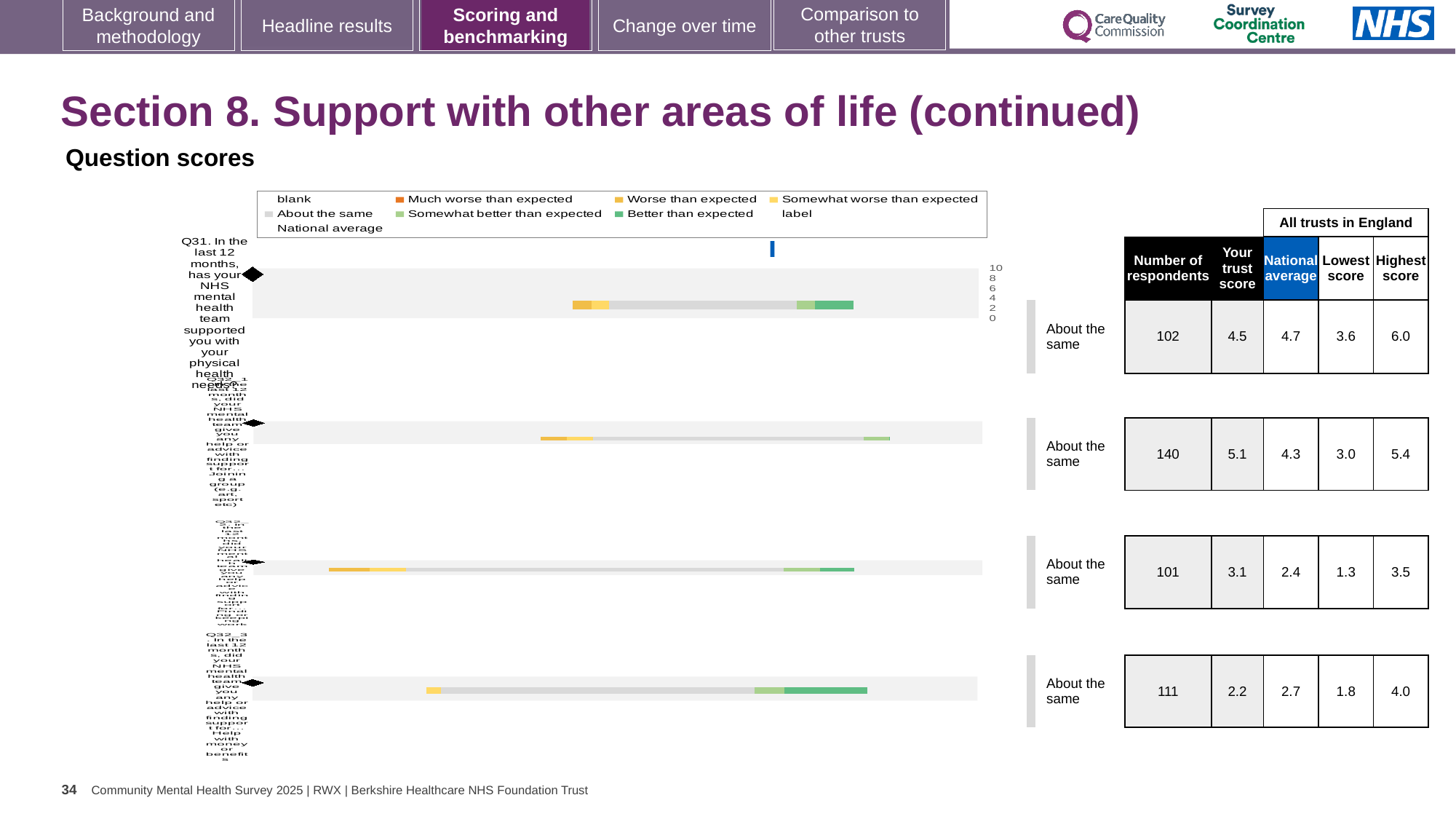
What colour does the legend use for 'Much worse than expected'? Orange What is the heading above the chart? Question scores Which row in the table beside the chart has the highest number of respondents? The second row (140 respondents) What kind of chart is shown on the slide? Bar chart For Q31 in the table beside the chart, what is the difference between the highest score and the lowest score? 2.4 According to the table beside the chart, how many respondents answered Q31 (support with physical health needs)? 102 According to the table beside the chart, what is the trust score for Q31 (support with physical health needs)? 4.5 What benchmark category is shown for all four questions in the chart? About the same How many entries does the chart legend list? 9 How many questions (bars) are plotted in the chart? 4 According to the table beside the chart, what is the national average for Q31 (support with physical health needs)? 4.7 In the second row of the table beside the chart, which is larger: the trust score or the national average? The trust score (5.1)